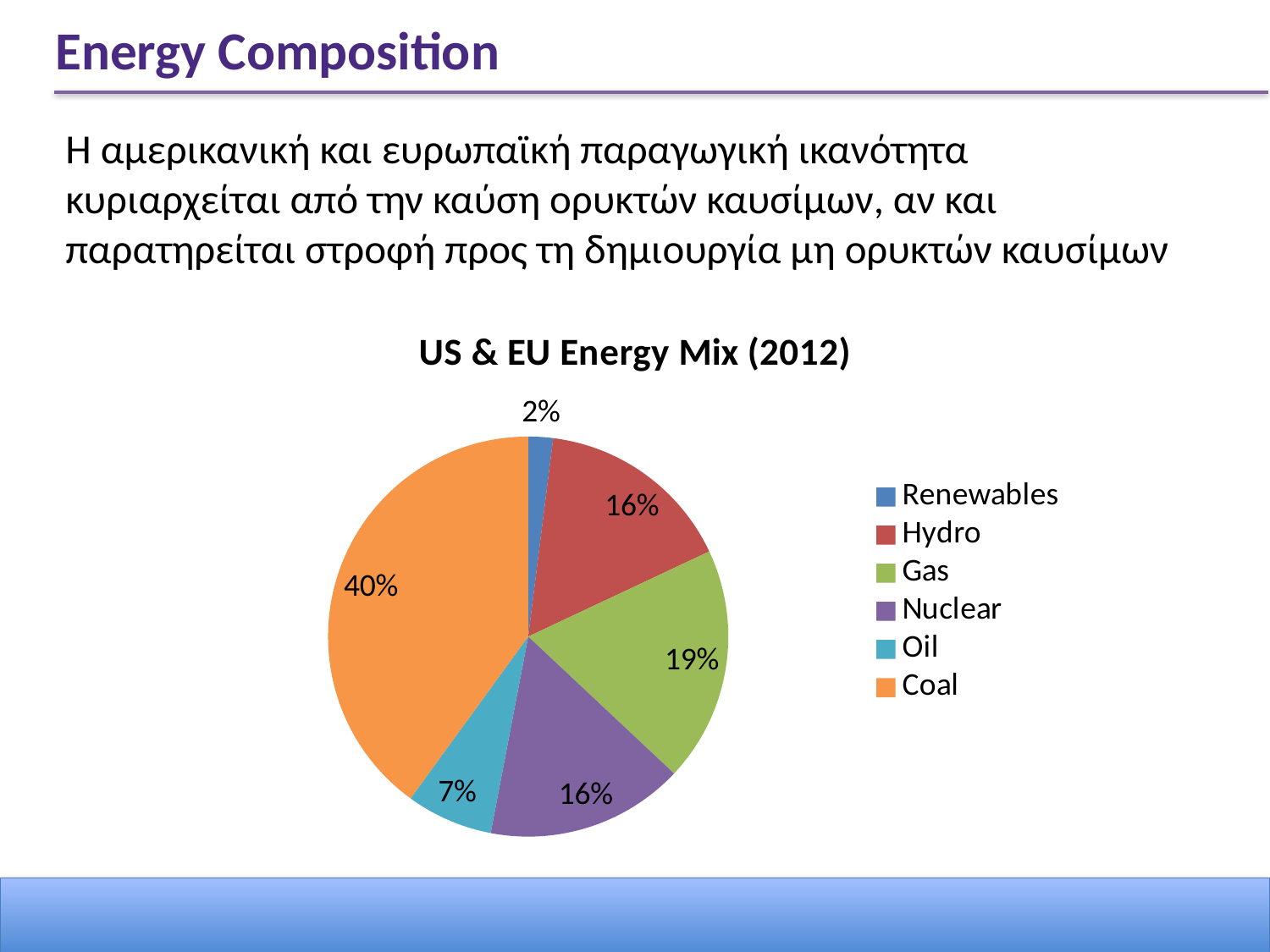
What colour is the Coal slice? orange What share of the pie does Renewables have? 2% Which category has the largest slice of the pie? Coal What share of the pie does Gas have? 19% Which category has the smallest slice of the pie? Renewables How many categories does the legend list? 6 Which is larger, the Gas slice or the Oil slice? Gas What is the difference between the Coal share and the Gas share? 21% What kind of chart is shown on the slide? pie chart What share of the pie does Coal have? 40% What is the title of the chart? US & EU Energy Mix (2012)